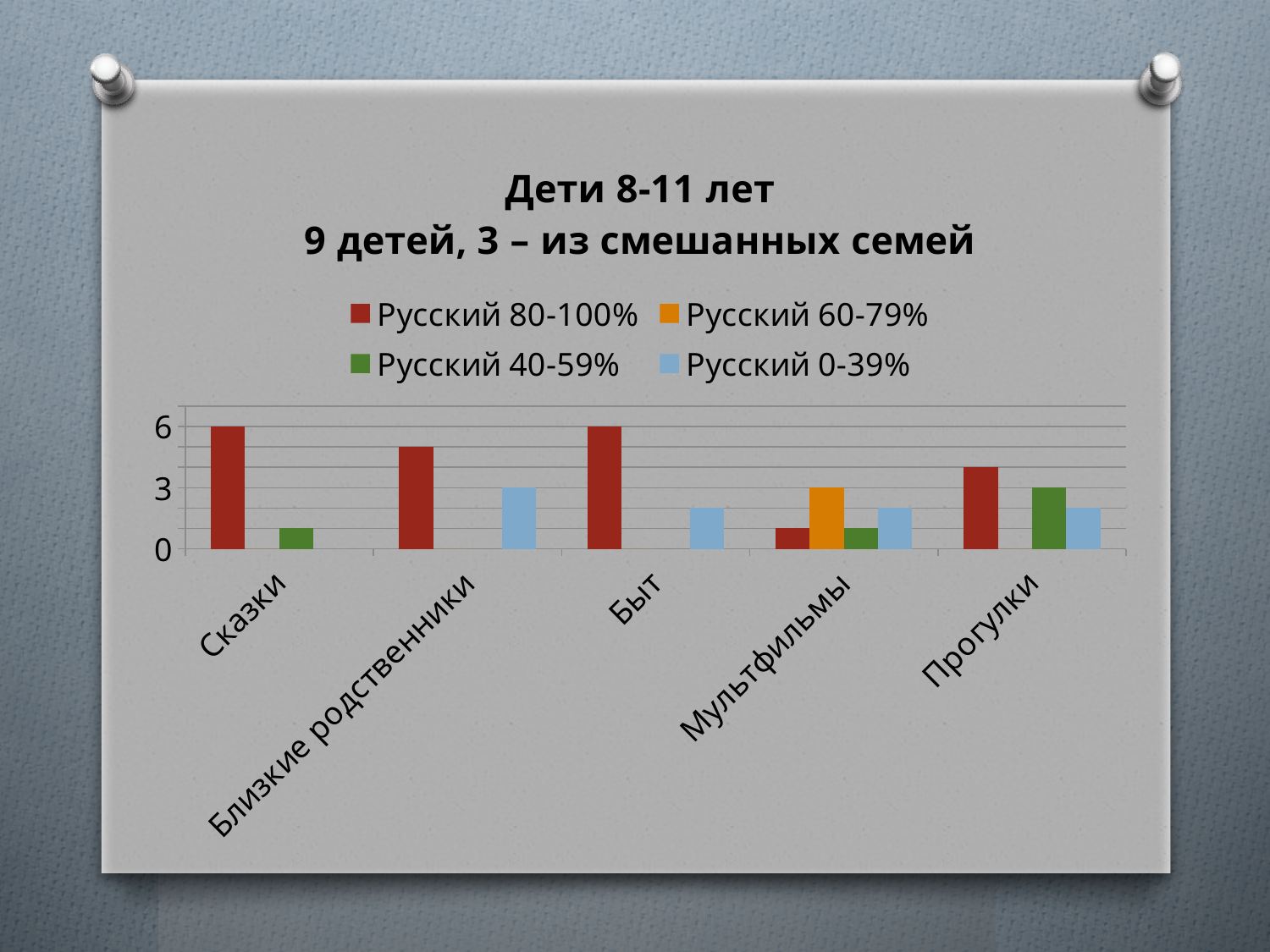
What is the value of Русский 0-39% for Близкие родственники? 3 What kind of chart is shown on the slide? bar chart Which is larger for Быт: Русский 80-100% or Русский 0-39%? Русский 80-100% How many series does the legend list? 4 Is the value of Русский 80-100% for Мультфильмы greater or less than 3? less What is the value of Русский 60-79% for Мультфильмы? 3 Which category has the lowest value for Русский 80-100%? Мультфильмы What is the value of Русский 40-59% for Прогулки? 3 Which category is the only one with a bar for Русский 60-79%? Мультфильмы What is the value of Русский 80-100% for Сказки? 6 How many categories are shown on the x axis? 5 Is the value of Русский 80-100% for Прогулки greater or less than 3? greater